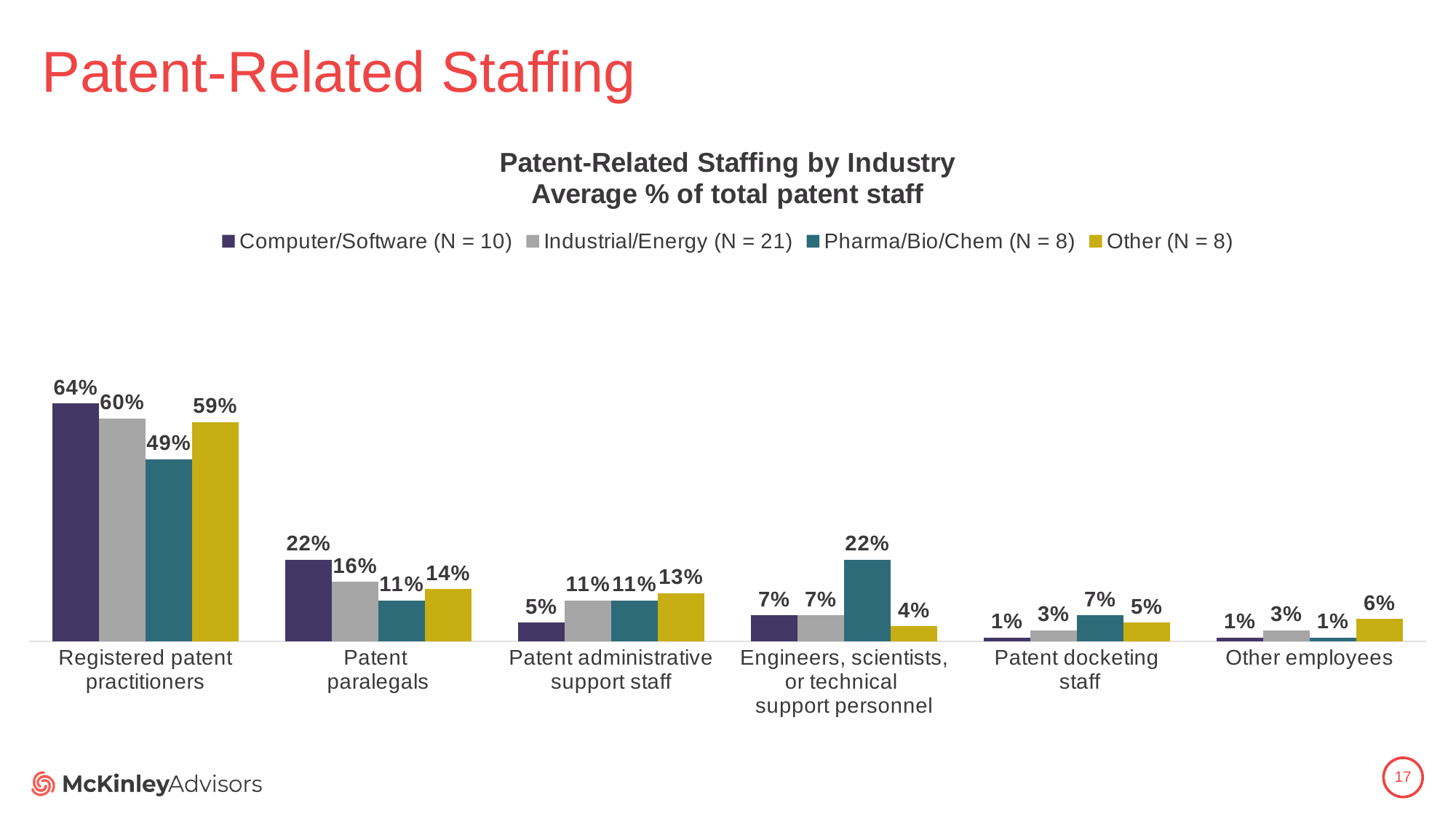
How many series does the legend list? 4 Which industry has the lowest value for Registered patent practitioners? Pharma/Bio/Chem (N = 8) What is the value for Pharma/Bio/Chem (N = 8) in the Engineers, scientists, or technical support personnel category? 22% Which is larger for Patent administrative support staff: Computer/Software or Other? Other What is the value for Other (N = 8) in the Patent docketing staff category? 5% Which industry has the highest value for Registered patent practitioners? Computer/Software (N = 10) What is the subtitle of the chart below its main title? Average % of total patent staff What is the value for Computer/Software (N = 10) in the Registered patent practitioners category? 64% What kind of chart is shown on the slide? Bar chart What is the difference between the Computer/Software and Pharma/Bio/Chem values for Patent paralegals? 11% What is the difference between the Pharma/Bio/Chem and Other values for Engineers, scientists, or technical support personnel? 18% How many staffing categories are shown on the x axis? 6